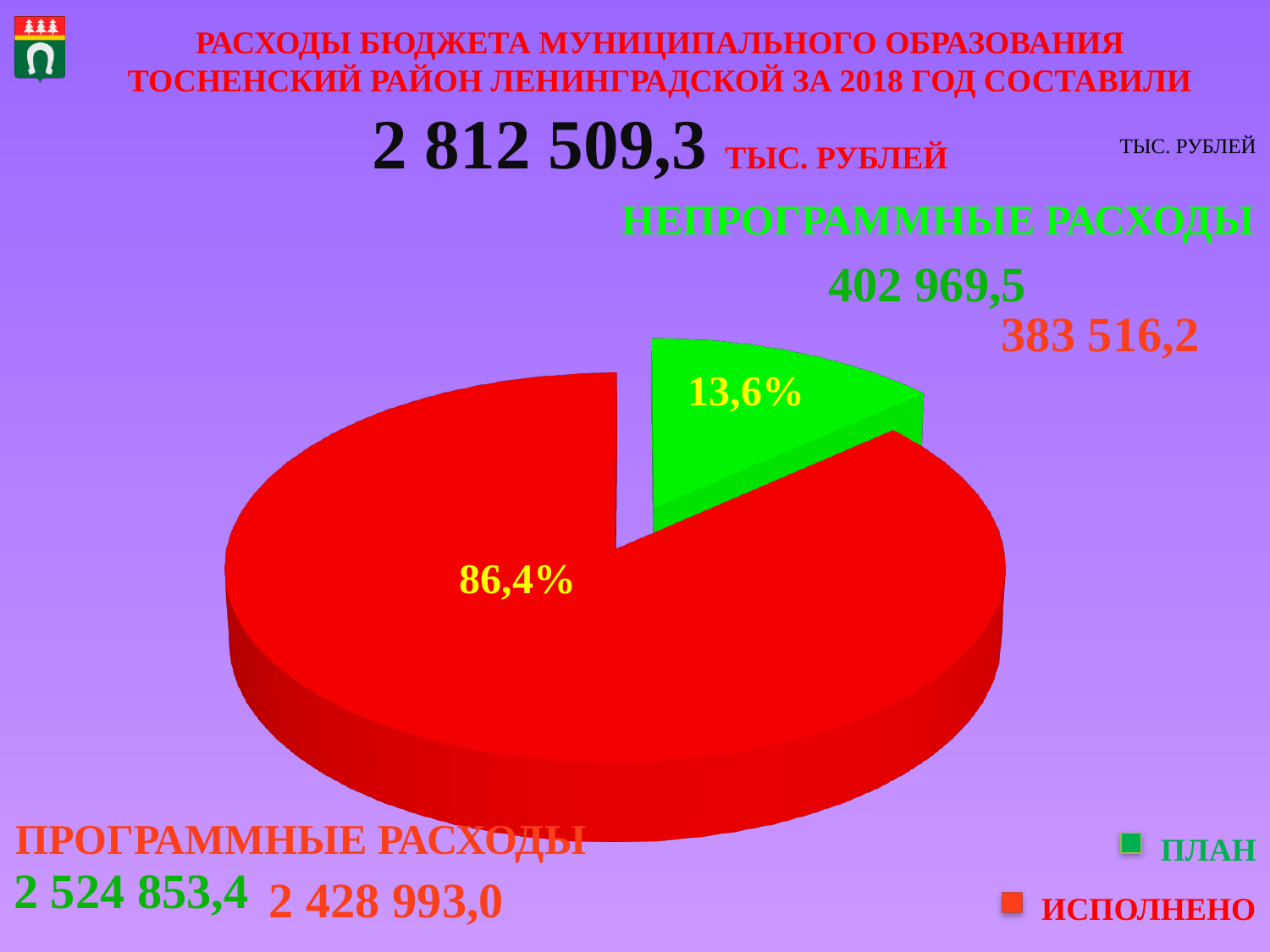
Which slice of the pie is larger, the green one or the red one? The red one (86,4%) How many entries does the chart legend list? 2 What is the difference in percentage points between the red slice (86,4%) and the green slice (13,6%)? 72,8 What is the ИСПОЛНЕНО value shown for ПРОГРАММНЫЕ РАСХОДЫ? 2 428 993,0 What is the difference between the ПЛАН and ИСПОЛНЕНО values for НЕПРОГРАММНЫЕ РАСХОДЫ? 19 453,3 What kind of chart is shown on the slide? Pie chart What share of the pie does the green slice represent? 13,6% What is the ПЛАН value shown for ПРОГРАММНЫЕ РАСХОДЫ? 2 524 853,4 What is the ПЛАН value shown for НЕПРОГРАММНЫЕ РАСХОДЫ? 402 969,5 What share of the pie does the red slice represent? 86,4% How many slices does the pie chart have? 2 What is the ИСПОЛНЕНО value shown for НЕПРОГРАММНЫЕ РАСХОДЫ? 383 516,2